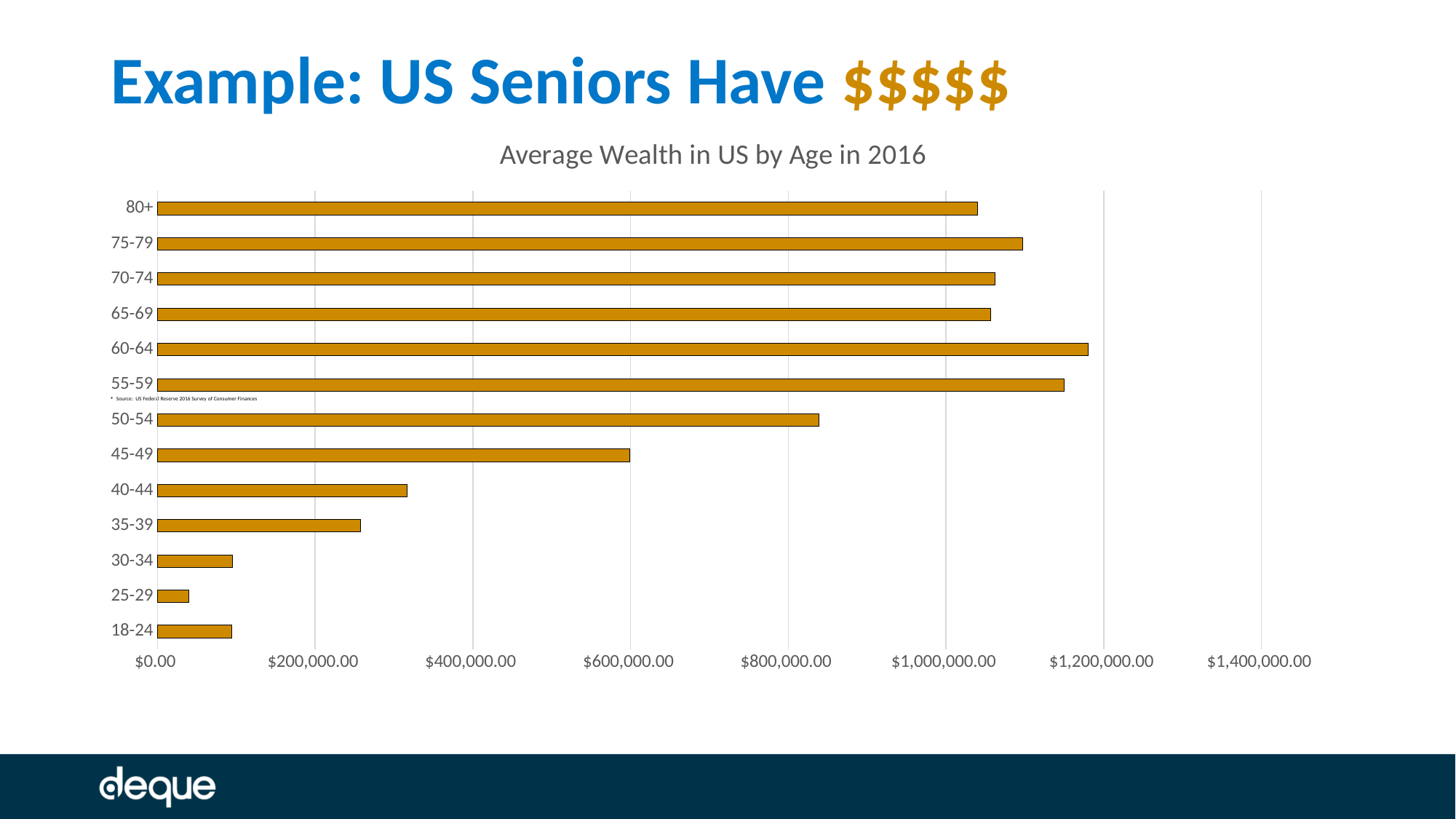
Is the value for 30-34 greater or less than $200,000.00? less Is the value for 60-64 greater or less than $1,200,000.00? less Which has the larger average wealth, 50-54 or 45-49? 50-54 Which age group has the lowest average wealth? 25-29 How many age groups are plotted in the chart? 13 Is the value for 80+ greater or less than $1,000,000.00? greater Which has the larger average wealth, 40-44 or 35-39? 40-44 What kind of chart is shown on the slide? bar chart Which age group has the highest average wealth? 60-64 What is the title of the chart? Average Wealth in US by Age in 2016 What is the highest value labelled on the horizontal axis? $1,400,000.00